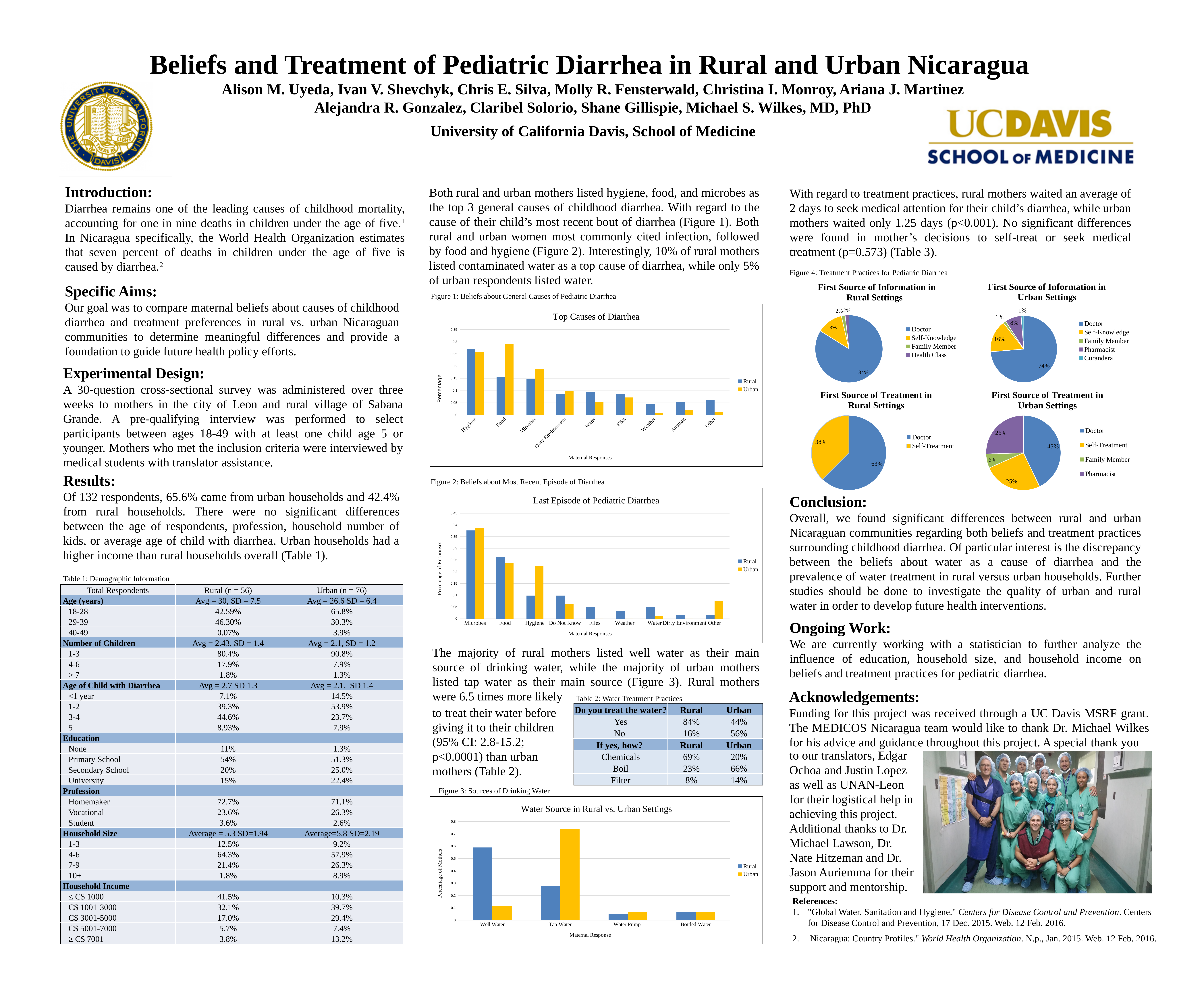
In the 'Last Episode of Pediatric Diarrhea' chart, which category has the highest Rural value? Microbes In the 'First Source of Treatment in Urban Settings' pie chart, what share is Pharmacist? 26% What kind of chart is the 'Top Causes of Diarrhea' chart (Figure 1)? bar chart In the 'Last Episode of Pediatric Diarrhea' chart, is the Rural value for Microbes greater or less than 0.3? greater In the 'Water Source in Rural vs. Urban Settings' chart, is the Urban value for Tap Water greater or less than 0.6? greater In the 'First Source of Treatment in Rural Settings' pie chart, what is the difference between the Doctor and Self-Treatment shares? 25% In the 'First Source of Information in Urban Settings' pie chart, what share is Doctor? 74% In the 'First Source of Treatment in Rural Settings' pie chart, what share is Doctor? 63% In the 'Top Causes of Diarrhea' chart, is the Urban value for Food greater or less than 0.25? greater In the 'Top Causes of Diarrhea' chart, how many series does the legend list? 2 How many categories are shown on the x axis of the 'Water Source in Rural vs. Urban Settings' chart? 4 In the 'Water Source in Rural vs. Urban Settings' chart, which is larger for Well Water, the Rural or the Urban value? Rural